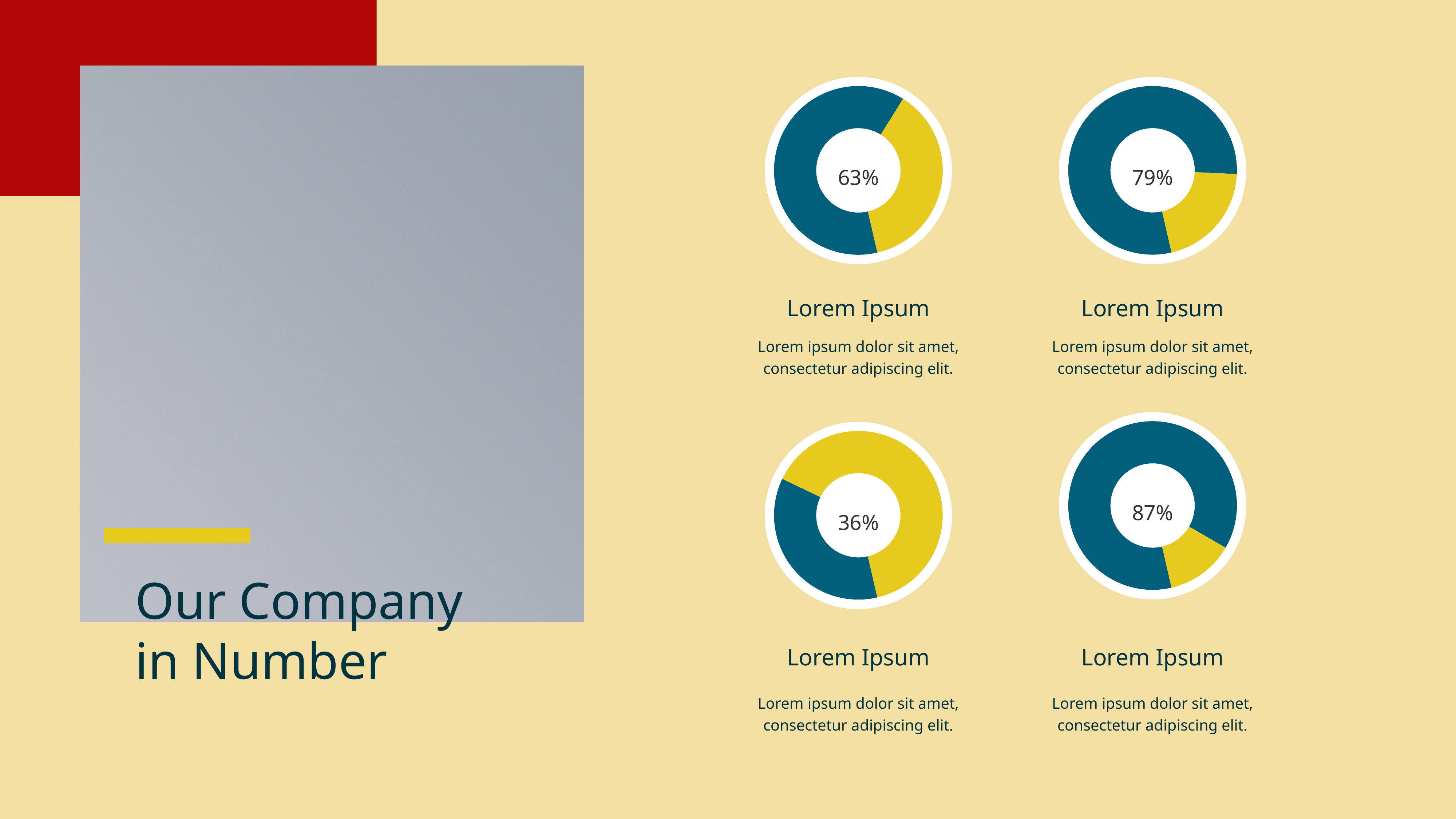
What percentage is shown in the centre of the top-left donut chart? 63% What percentage is shown in the centre of the top-right donut chart? 79% What percentage is shown in the centre of the bottom-left donut chart? 36% How many donut charts are on the slide? 4 What is the difference between the percentage in the top-right donut chart and the percentage in the top-left donut chart? 16% What percentage is shown in the centre of the bottom-right donut chart? 87% What is the difference between the percentage in the bottom-right donut chart and the percentage in the bottom-left donut chart? 51% Which of the four donut charts shows the highest percentage? bottom-right (87%) Which shows a larger percentage, the top-left donut chart or the top-right donut chart? top-right What colour is the larger segment of the bottom-left donut chart? yellow Which of the four donut charts shows the lowest percentage? bottom-left (36%) What kind of chart is used to display the percentages on the slide? donut chart